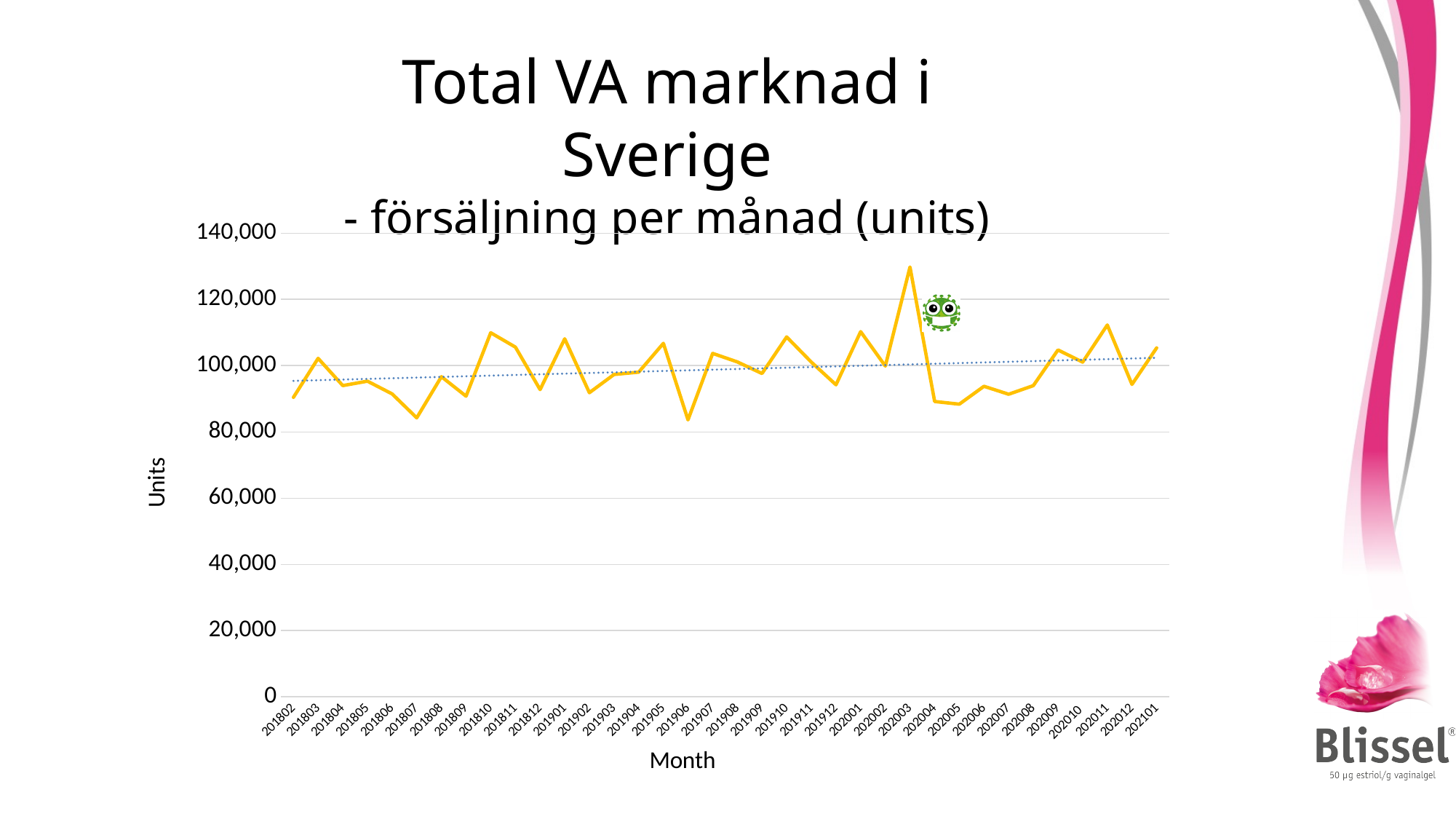
Is the value for 202004 greater or less than 100,000? less What kind of chart is shown on the slide? line chart Which is larger, the value for 202003 or the value for 202004? 202003 How many months are plotted along the x axis? 36 What is the label of the vertical axis? Units Is the value for 202003 greater or less than 120,000? greater Is the value for 201802 greater or less than 100,000? less Which is larger, the value for 201810 or the value for 201807? 201810 Does the dotted trend line rise or fall from left to right? rises Which month has the highest value? 202003